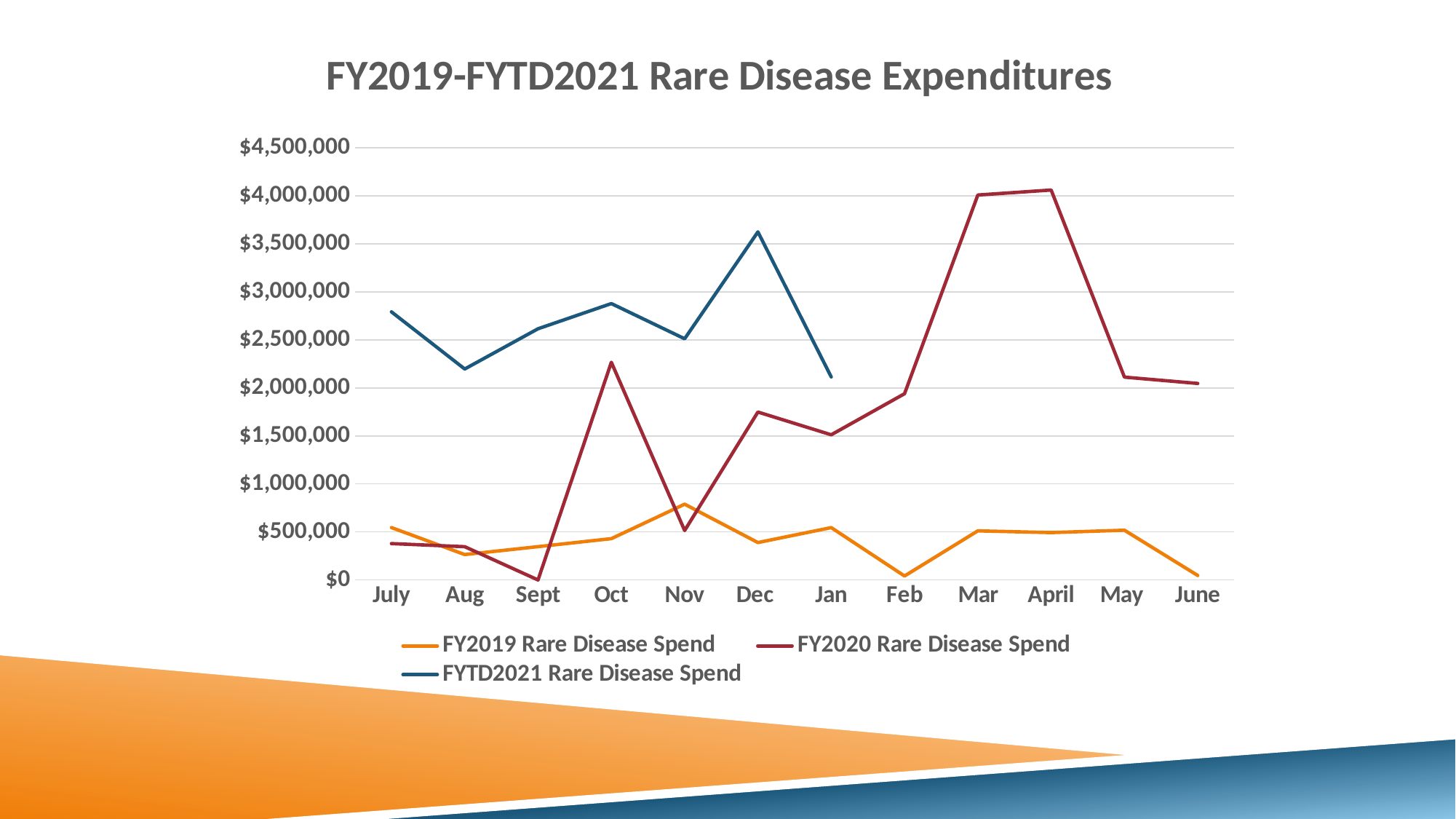
Does the FY2020 Rare Disease Spend rise or fall from Feb to Mar? Rise How many months are shown on the x axis? 12 Is the FYTD2021 Rare Disease Spend for Dec greater or less than $3,500,000? greater In which month is the FY2020 Rare Disease Spend lowest? Sept In which month is the FY2019 Rare Disease Spend highest? Nov How many series does the legend list? 3 How many months have a plotted value for the FYTD2021 Rare Disease Spend series? 7 In which month is the FYTD2021 Rare Disease Spend highest? Dec Is the FY2019 Rare Disease Spend for Nov greater or less than $1,000,000? less What type of chart is shown on the slide? Line chart What is the title of the chart? FY2019-FYTD2021 Rare Disease Expenditures In Nov, which is larger: the FY2019 Rare Disease Spend or the FY2020 Rare Disease Spend? FY2019 Rare Disease Spend